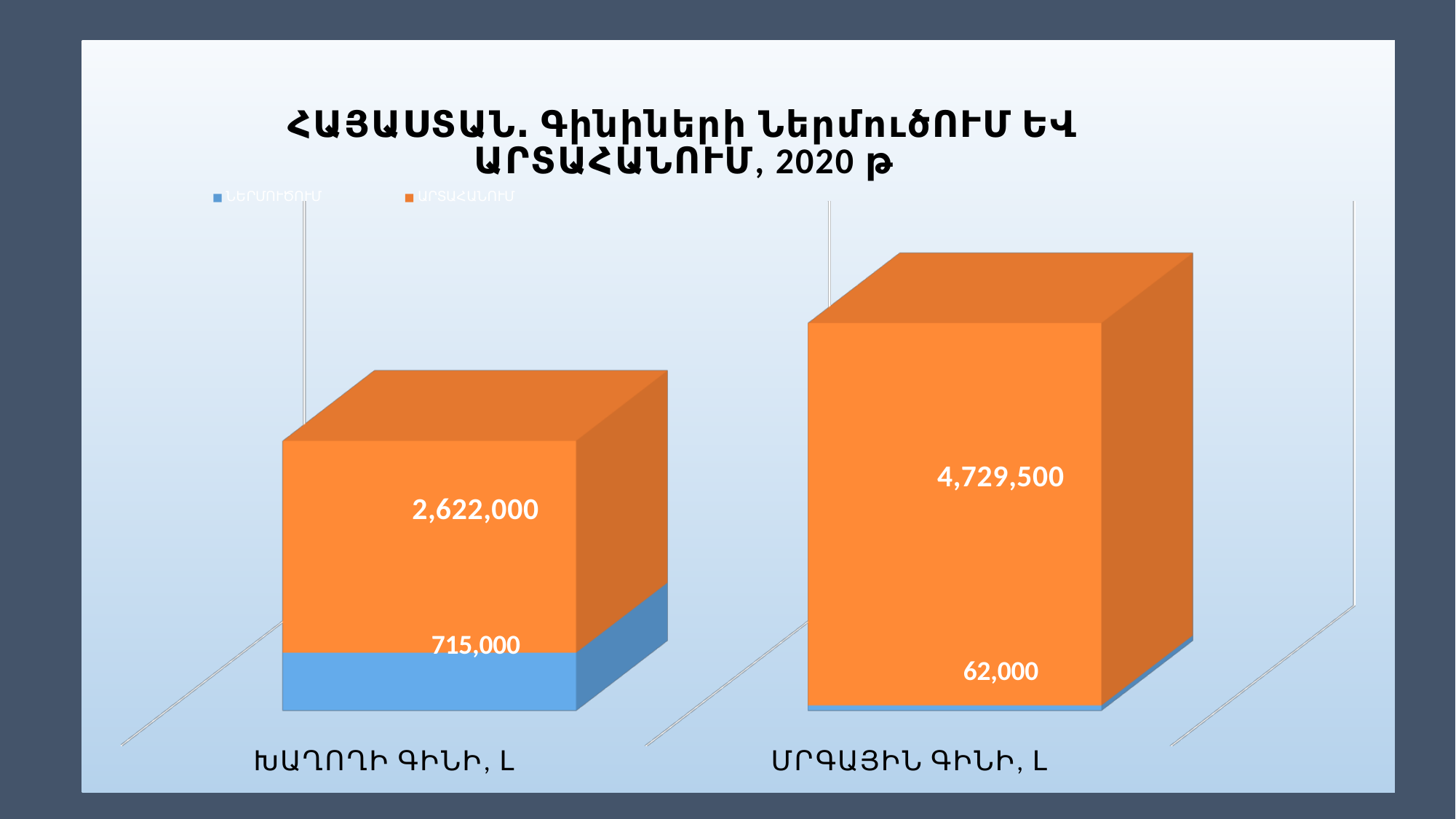
What is the total of the stacked bar for ԽԱՂՈՂԻ ԳԻՆԻ, L? 3,337,000 What is the total of the stacked bar for ՄՐԳԱՅԻՆ ԳԻՆԻ, L? 4,791,500 What is the import (ՆԵՐՄՈՒԾՈՒՄ) value for ՄՐԳԱՅԻՆ ԳԻՆԻ, L? 62,000 Which category has the higher export (ԱՐՏԱՀԱՆՈՒՄ) value? ՄՐԳԱՅԻՆ ԳԻՆԻ, L What is the difference between the export values of ՄՐԳԱՅԻՆ ԳԻՆԻ, L and ԽԱՂՈՂԻ ԳԻՆԻ, L? 2,107,500 What is the export (ԱՐՏԱՀԱՆՈՒՄ) value for ՄՐԳԱՅԻՆ ԳԻՆԻ, L? 4,729,500 What is the export (ԱՐՏԱՀԱՆՈՒՄ) value for ԽԱՂՈՂԻ ԳԻՆԻ, L? 2,622,000 How many series does the legend list? 2 What kind of chart is shown on the slide? Stacked bar chart What is the import (ՆԵՐՄՈՒԾՈՒՄ) value for ԽԱՂՈՂԻ ԳԻՆԻ, L? 715,000 Which category has the lower import (ՆԵՐՄՈՒԾՈՒՄ) value? ՄՐԳԱՅԻՆ ԳԻՆԻ, L What is the difference between the import values of ԽԱՂՈՂԻ ԳԻՆԻ, L and ՄՐԳԱՅԻՆ ԳԻՆԻ, L? 653,000